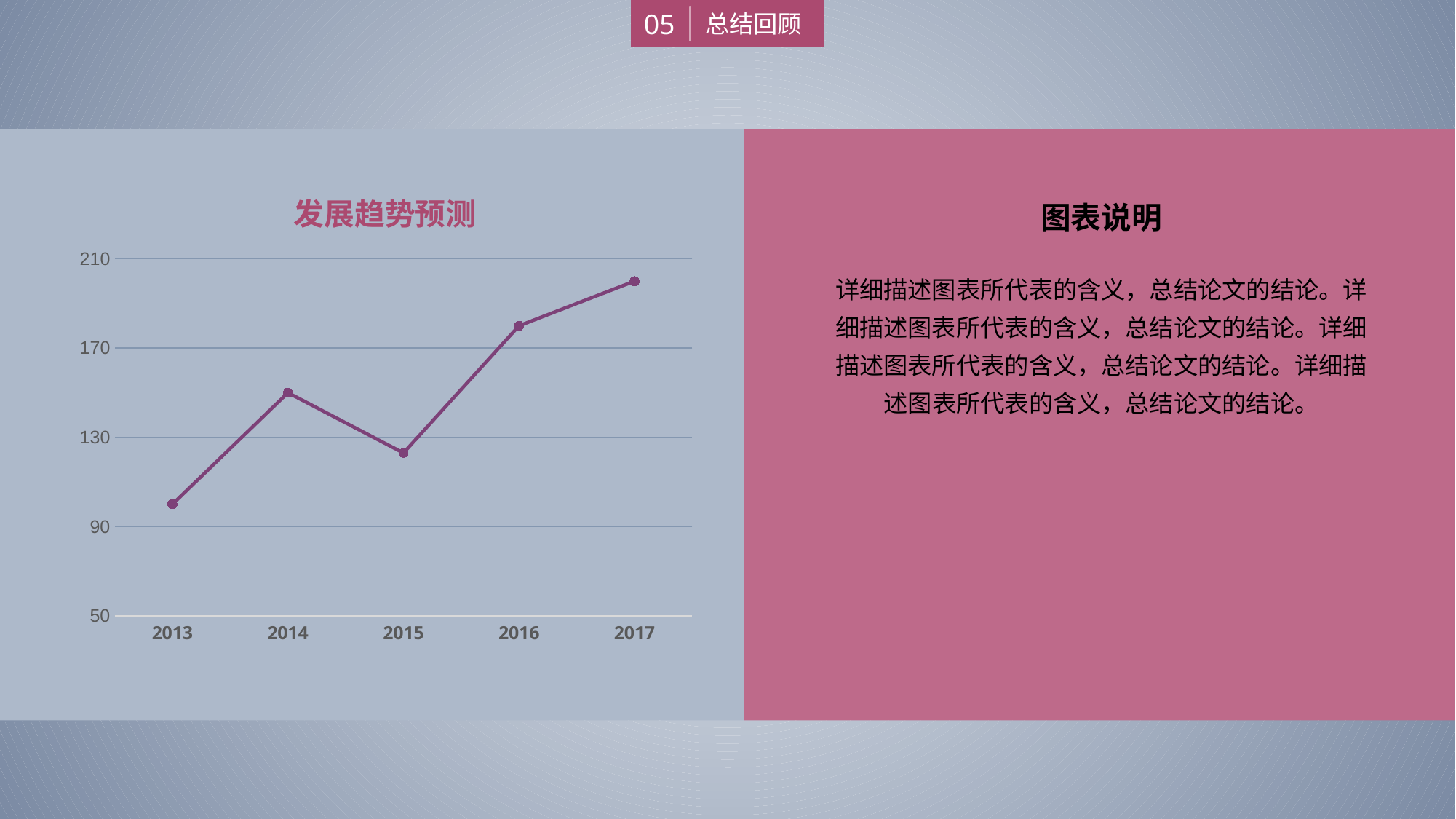
Is the value for 2015 greater or less than 130? less What is the title of the chart? 发展趋势预测 Which year has the highest value in the chart? 2017 Which year has the lowest value in the chart? 2013 What kind of chart is shown on the slide? line chart How many years are plotted on the x axis of the chart? 5 Which year has the larger value, 2014 or 2015? 2014 Is the value for 2016 greater or less than 170? greater Is the value for 2014 greater or less than 130? greater Does the value fall or rise from 2014 to 2015? fall